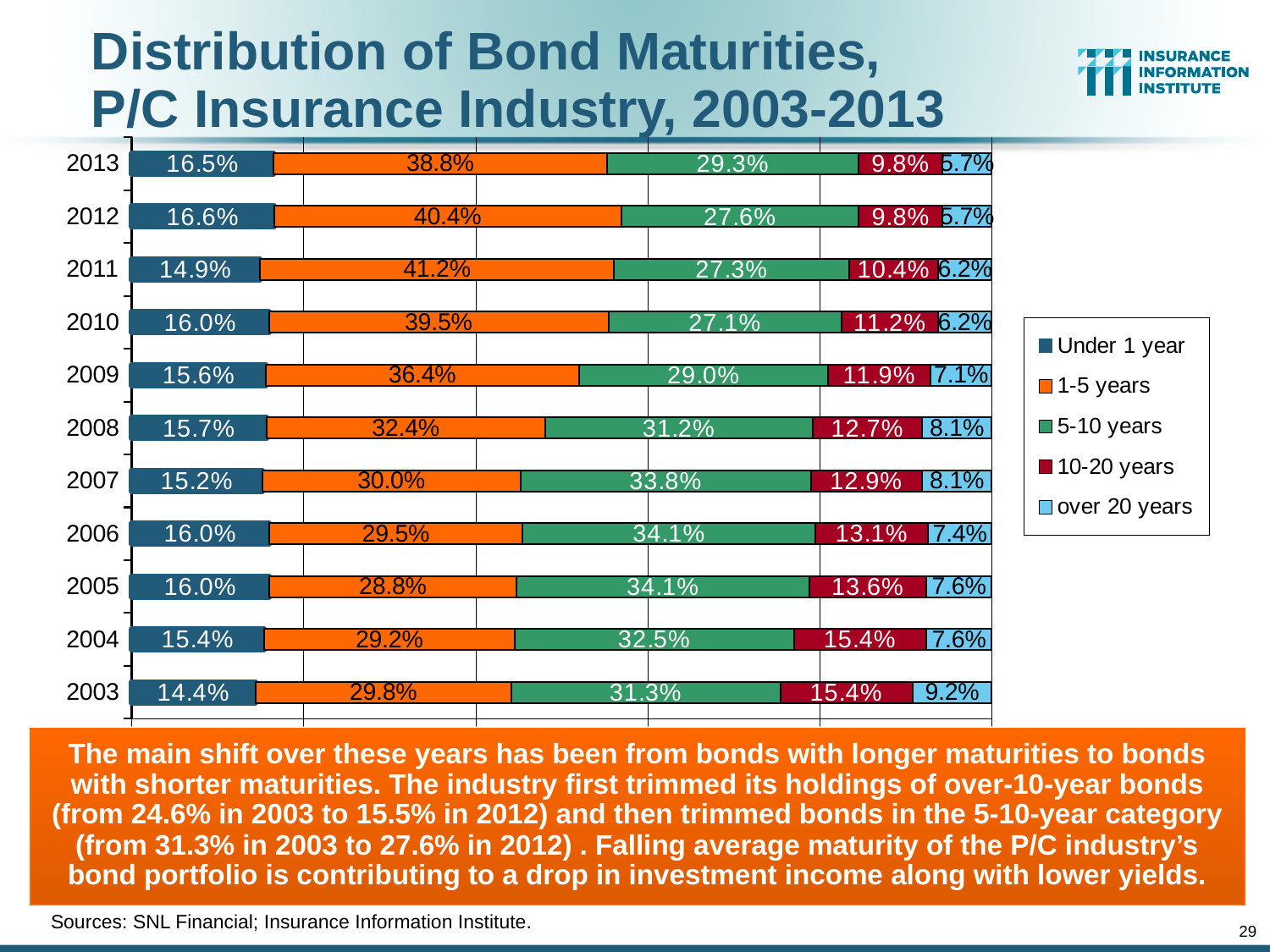
By how many percentage points did the 1-5 years share in 2013 exceed that in 2003? 9.0 percentage points What percentage of bonds had maturities over 20 years in 2009? 7.1% How many years are shown on the chart? 11 What share of bonds had maturities of 1-5 years in 2013? 38.8% What was the 10-20 years share in 2004? 15.4% How many maturity categories does the legend list? 5 Which was larger in 2007: the 1-5 years share or the 5-10 years share? 5-10 years In which year was the 1-5 years share the highest? 2011 What type of chart is shown on the slide? Stacked bar chart What was the 5-10 years share in 2003? 31.3% In which year was the 5-10 years share the lowest? 2010 Did the over 20 years share rise or fall from 2003 to 2013? Fall